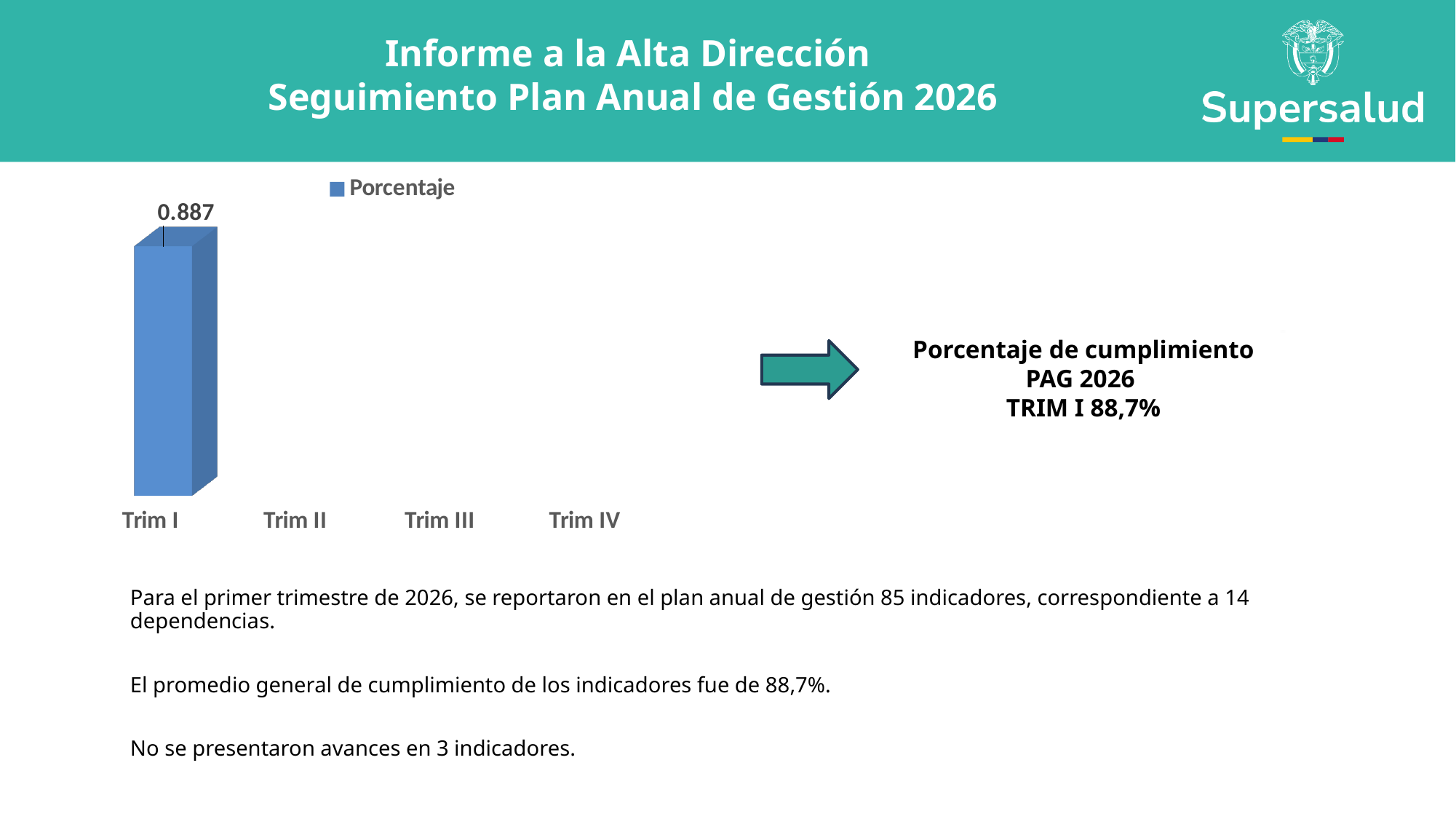
What kind of chart is shown on the slide? Bar chart What is the name of the series listed in the legend? Porcentaje What is the value shown for Trim I? 0.887 Which category is the only one with a bar plotted? Trim I Which category has the highest value in the chart? Trim I How many categories on the x axis have no bar plotted? 3 How many categories are shown on the x axis of the chart? 4 How many series does the legend list? 1 What is the label of the last category on the x axis? Trim IV